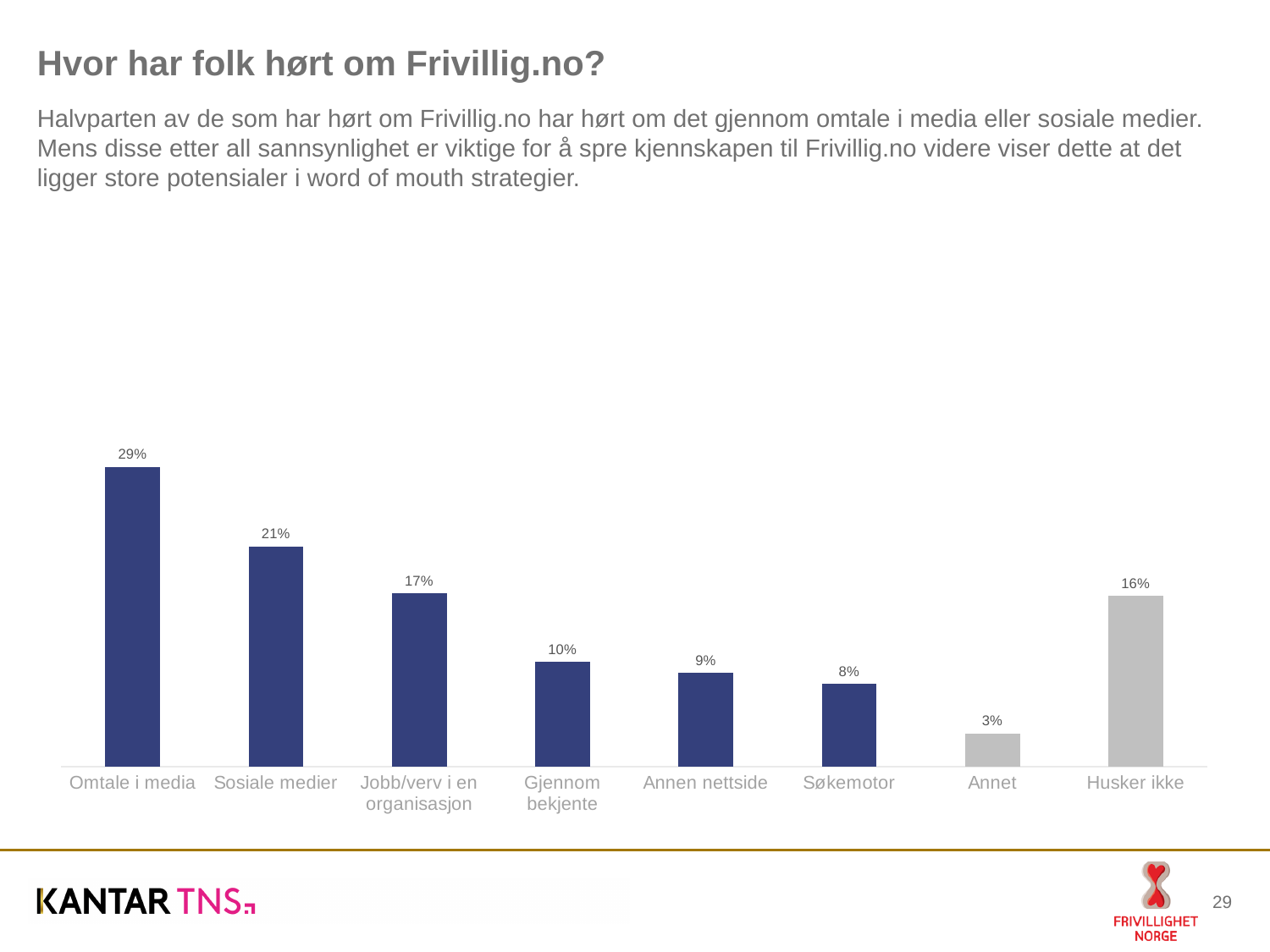
What is the difference between Omtale i media and Sosiale medier? 8% Which category has the lowest value? Annet Which bars are coloured grey rather than dark blue? Annet and Husker ikke Which is larger, Husker ikke or Jobb/verv i en organisasjon? Jobb/verv i en organisasjon What is the difference between Jobb/verv i en organisasjon and Gjennom bekjente? 7% What is the value for Husker ikke? 16% What kind of chart is shown on the slide? Bar chart What is the value for Omtale i media? 29% How many categories are shown in the chart? 8 What is the value for Sosiale medier? 21% What is the value for Søkemotor? 8% Which category has the highest value? Omtale i media